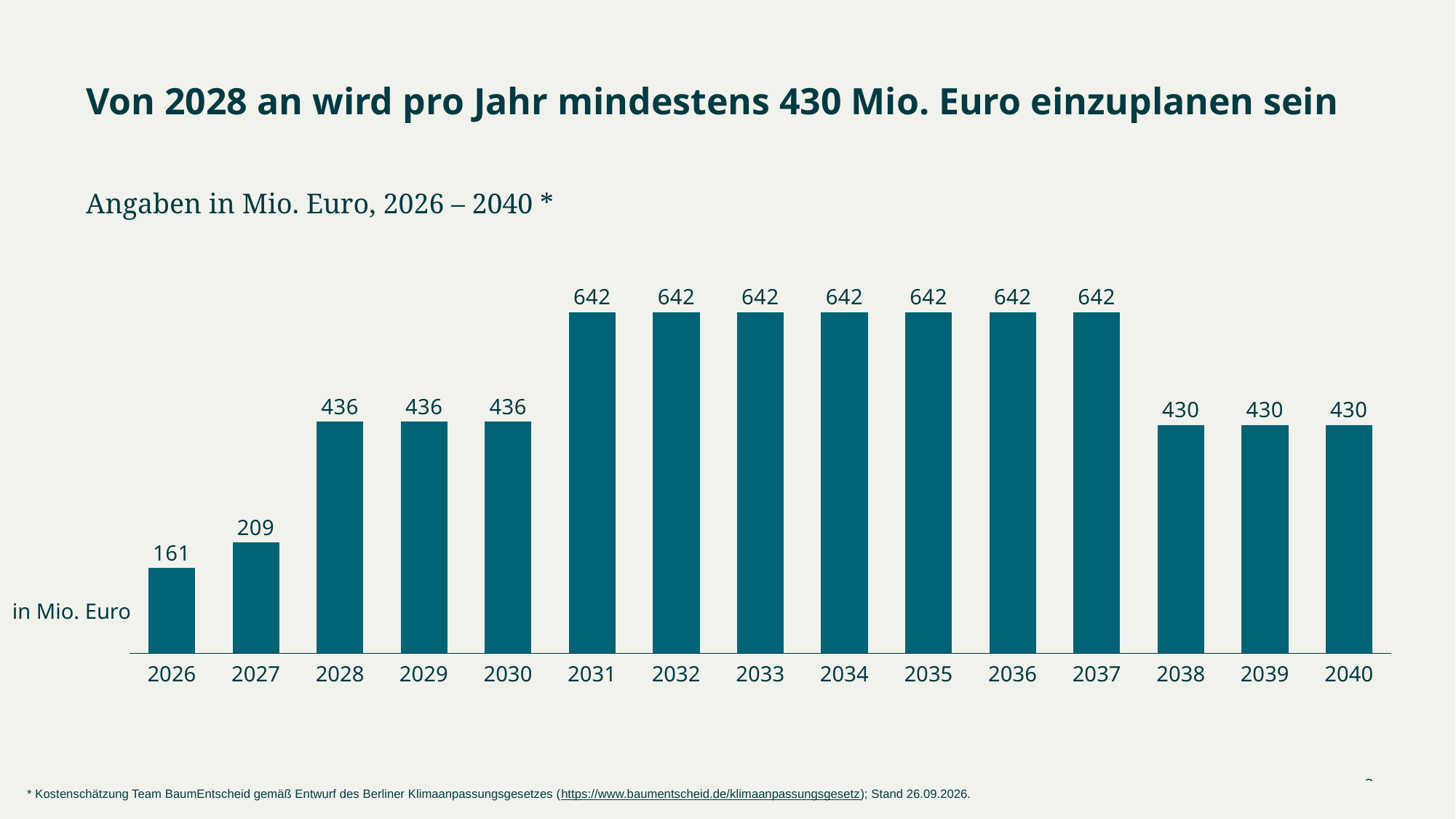
What is the difference between the values for 2027 and 2026? 48 What is the title of the slide? Von 2028 an wird pro Jahr mindestens 430 Mio. Euro einzuplanen sein What is the difference between the values for 2031 and 2030? 206 What is the value for 2034? 642 What kind of chart is shown on the slide? bar chart What is the value for 2039? 430 What is the value for 2027? 209 How many years are shown on the x axis? 15 What is the value for 2029? 436 Which year has the lowest value? 2026 Which is larger, the value for 2028 or the value for 2038? 2028 What is the value for 2026? 161